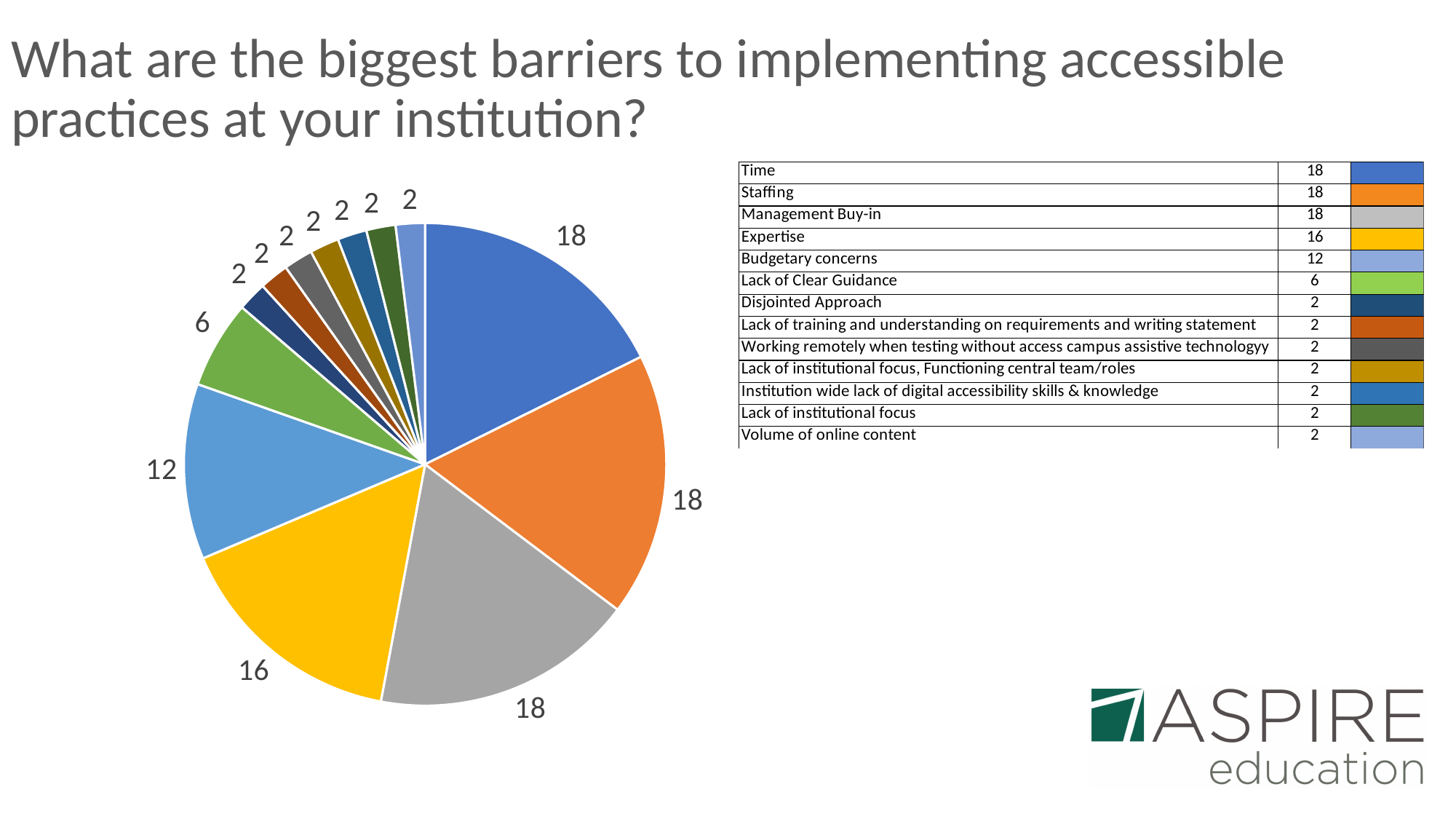
Which is larger, the value for Lack of Clear Guidance or the value for Disjointed Approach? Lack of Clear Guidance What is the value for Budgetary concerns? 12 What is the difference between the values for Time and Lack of Clear Guidance? 12 What is the value for Volume of online content? 2 What is the difference between the values for Expertise and Budgetary concerns? 4 How many categories does the pie chart have? 13 What kind of chart is shown on the slide? pie chart What is the value for Expertise? 16 What is the value for Lack of Clear Guidance? 6 How many categories have a value of 2? 7 What colour is the slice for Expertise? yellow Which is larger, the value for Expertise or the value for Budgetary concerns? Expertise